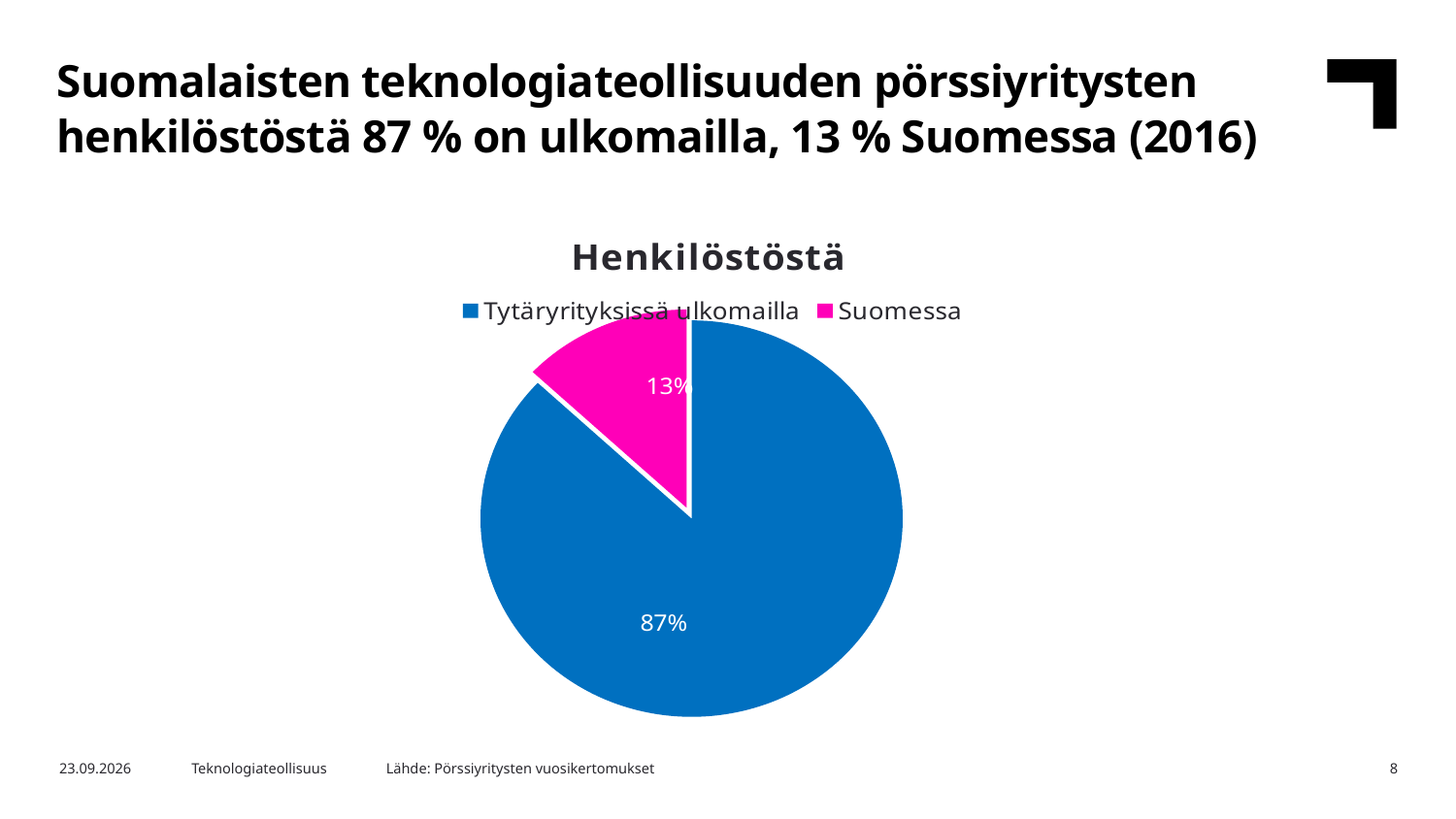
What share of the pie does Suomessa represent? 13% What colour is the Suomessa slice? Magenta (pink) How many entries does the legend list? 2 What is the title of the chart? Henkilöstöstä Which is larger, the Suomessa slice or the Tytäryrityksissä ulkomailla slice? Tytäryrityksissä ulkomailla Which category has the largest slice of the pie? Tytäryrityksissä ulkomailla What is the difference in percentage points between the Tytäryrityksissä ulkomailla slice and the Suomessa slice? 74 percentage points What kind of chart is shown on the slide? Pie chart How many slices does the pie chart have? 2 What share of the pie does Tytäryrityksissä ulkomailla represent? 87% Which category has the smallest slice of the pie? Suomessa